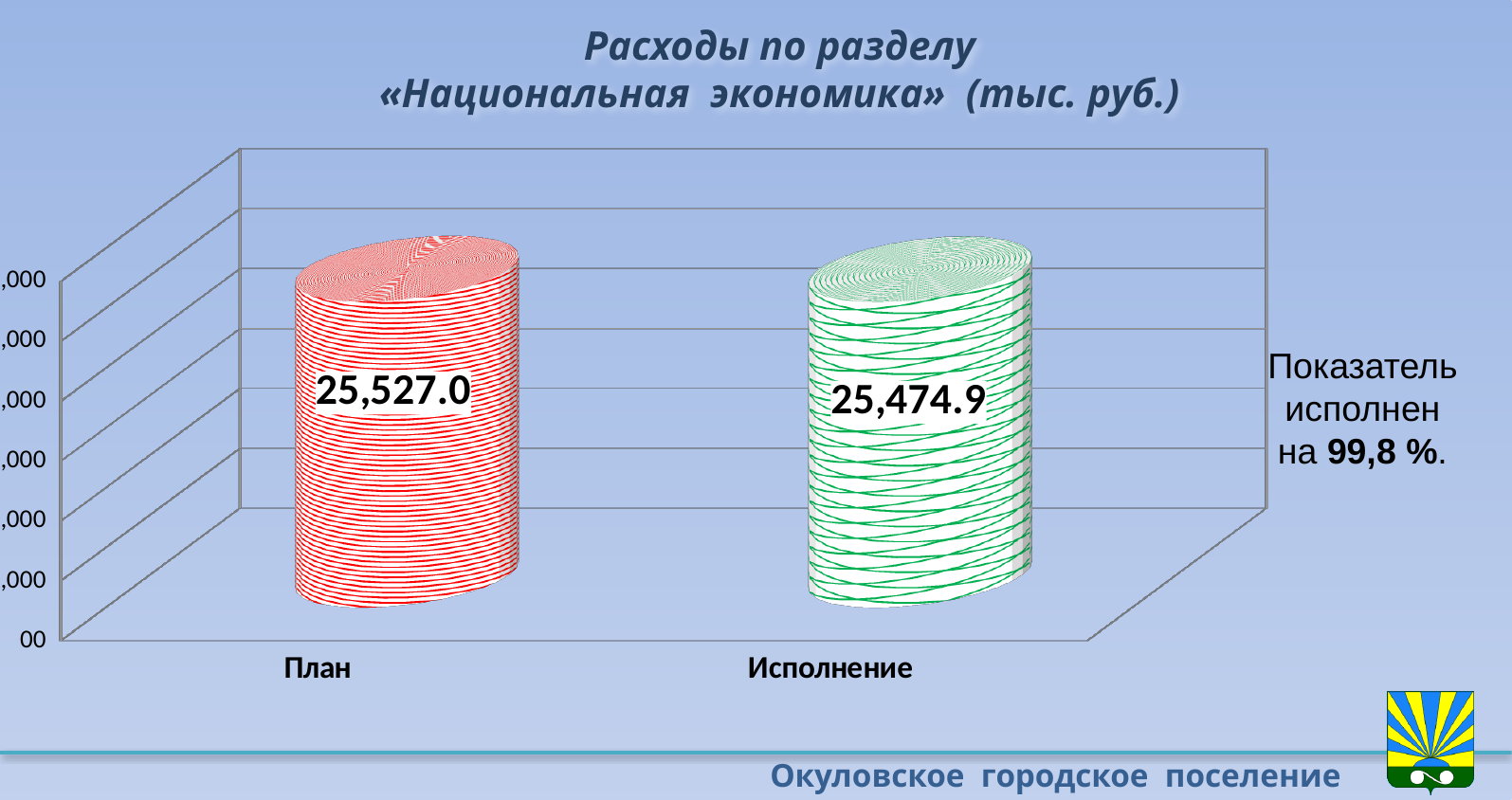
What is the value for План? 25,527.0 What is the title of the chart? Расходы по разделу «Национальная экономика» (тыс. руб.) Which category has the lowest value? Исполнение What is the difference between the values for План and Исполнение? 52.1 Do the values rise or fall from План to Исполнение? Fall What kind of chart is shown on the slide? Bar chart What is the value for Исполнение? 25,474.9 Which category has the higher value, План or Исполнение? План How many categories are shown on the chart? 2 Which category has the highest value? План According to the text next to the chart, by what percentage was the indicator fulfilled? 99,8 %